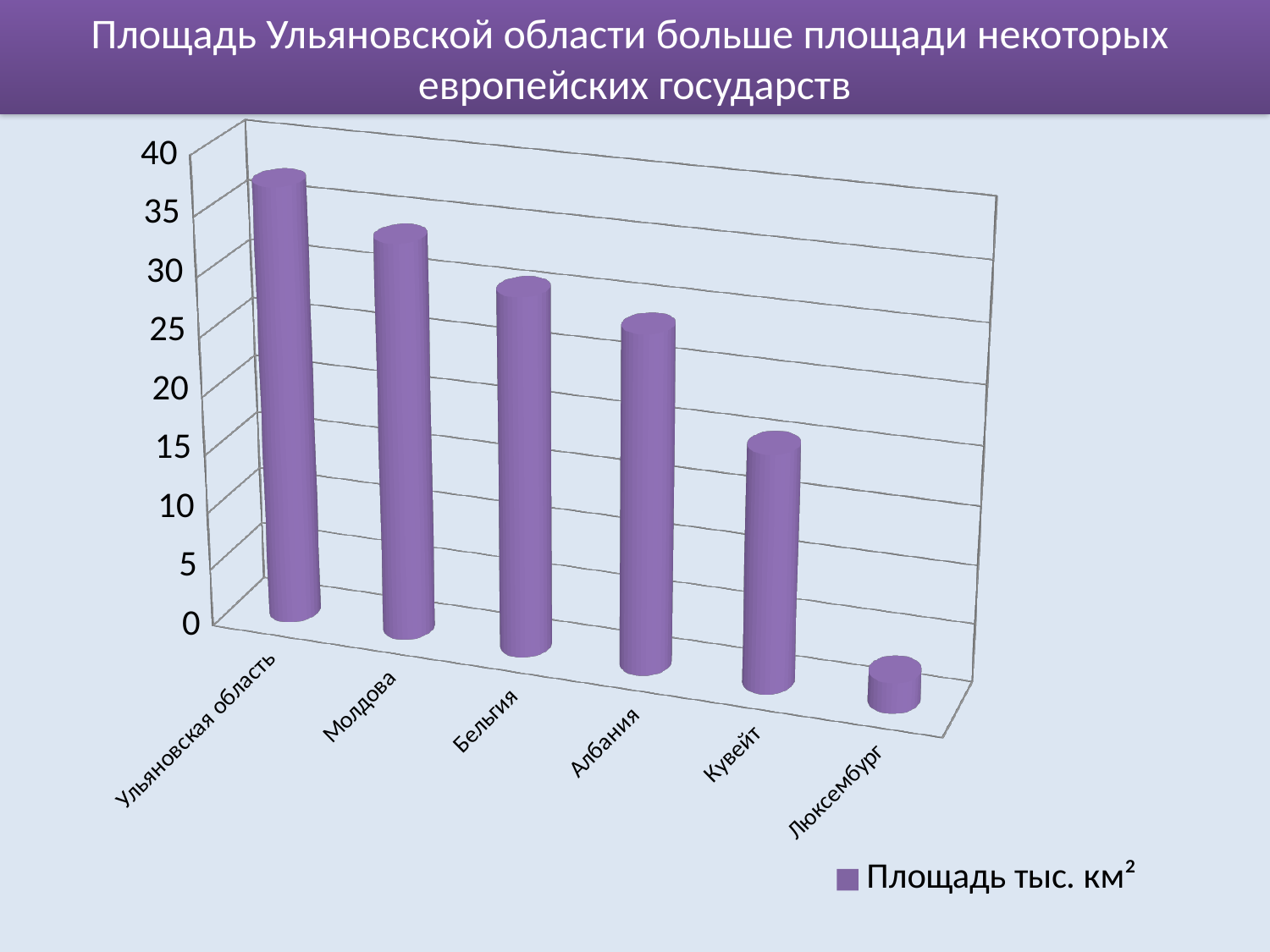
Which category has the highest value on the chart? Ульяновская область Which category has the lowest value on the chart? Люксембург How many categories are plotted on the chart? 6 Is the value for Ульяновская область greater or less than 30? greater Is the value for Кувейт greater or less than 10? greater How many series does the legend list? 1 What is the legend entry for the plotted series? Площадь тыс. км² Do the values rise or fall moving from left to right along the x axis? fall Is the value for Люксембург greater or less than 5? less Which is larger, the value for Молдова or the value for Кувейт? Молдова What kind of chart is shown on the slide? bar chart